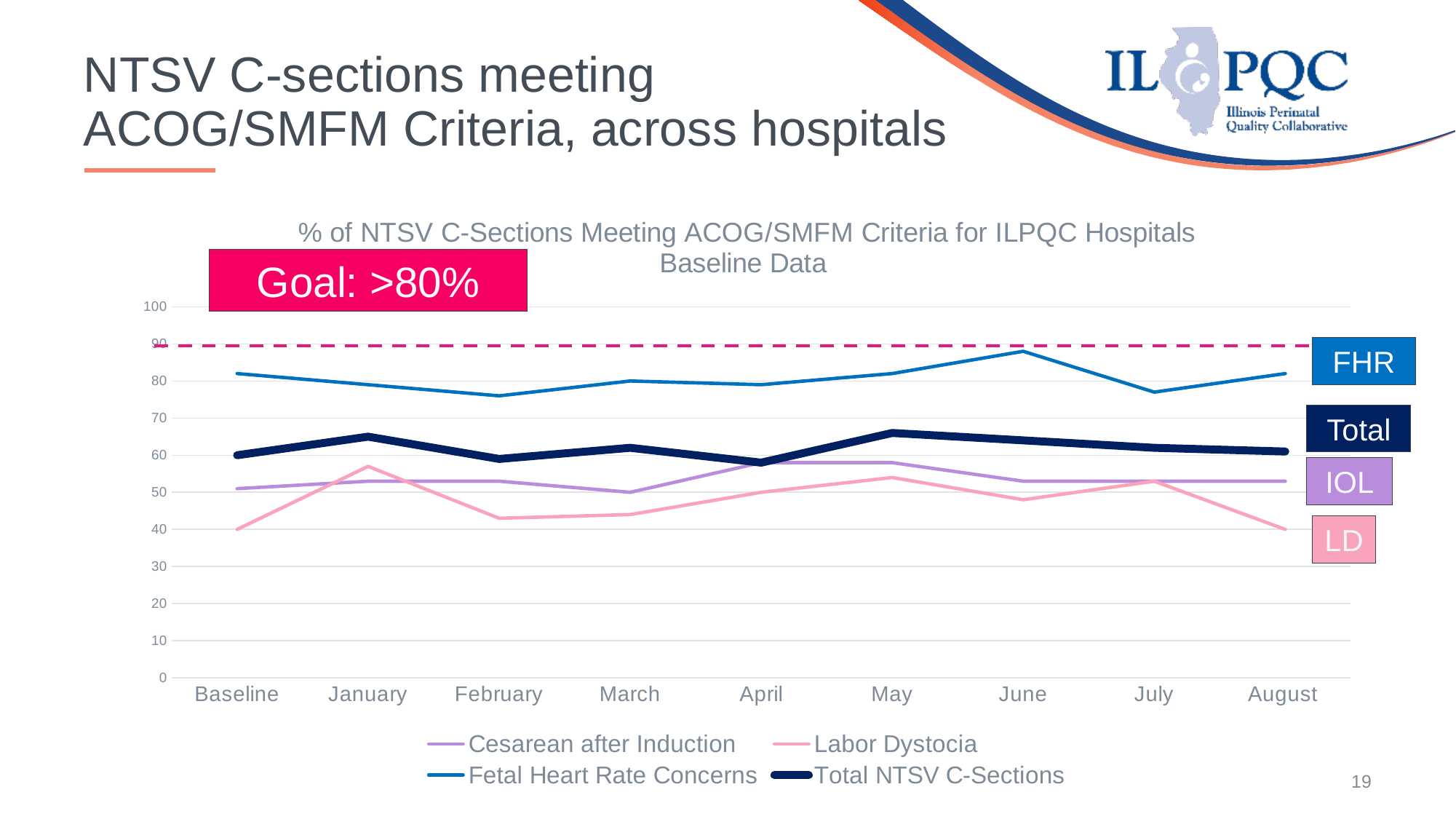
What goal is stated in the pink box on the chart? Goal: >80% At Baseline, which is larger: Cesarean after Induction or Labor Dystocia? Cesarean after Induction Does the Fetal Heart Rate Concerns line rise or fall from June to July? fall How many time points are shown along the x axis? 9 In which month does the Fetal Heart Rate Concerns line reach its highest value? June In which month does the Labor Dystocia line reach its highest value? January How many series does the legend list? 4 Is the value for Total NTSV C-Sections at Baseline greater or less than 50? greater Is the value for Fetal Heart Rate Concerns in June greater or less than 80? greater Is the value for Labor Dystocia at Baseline greater or less than 50? less What kind of chart is shown on the slide? line chart